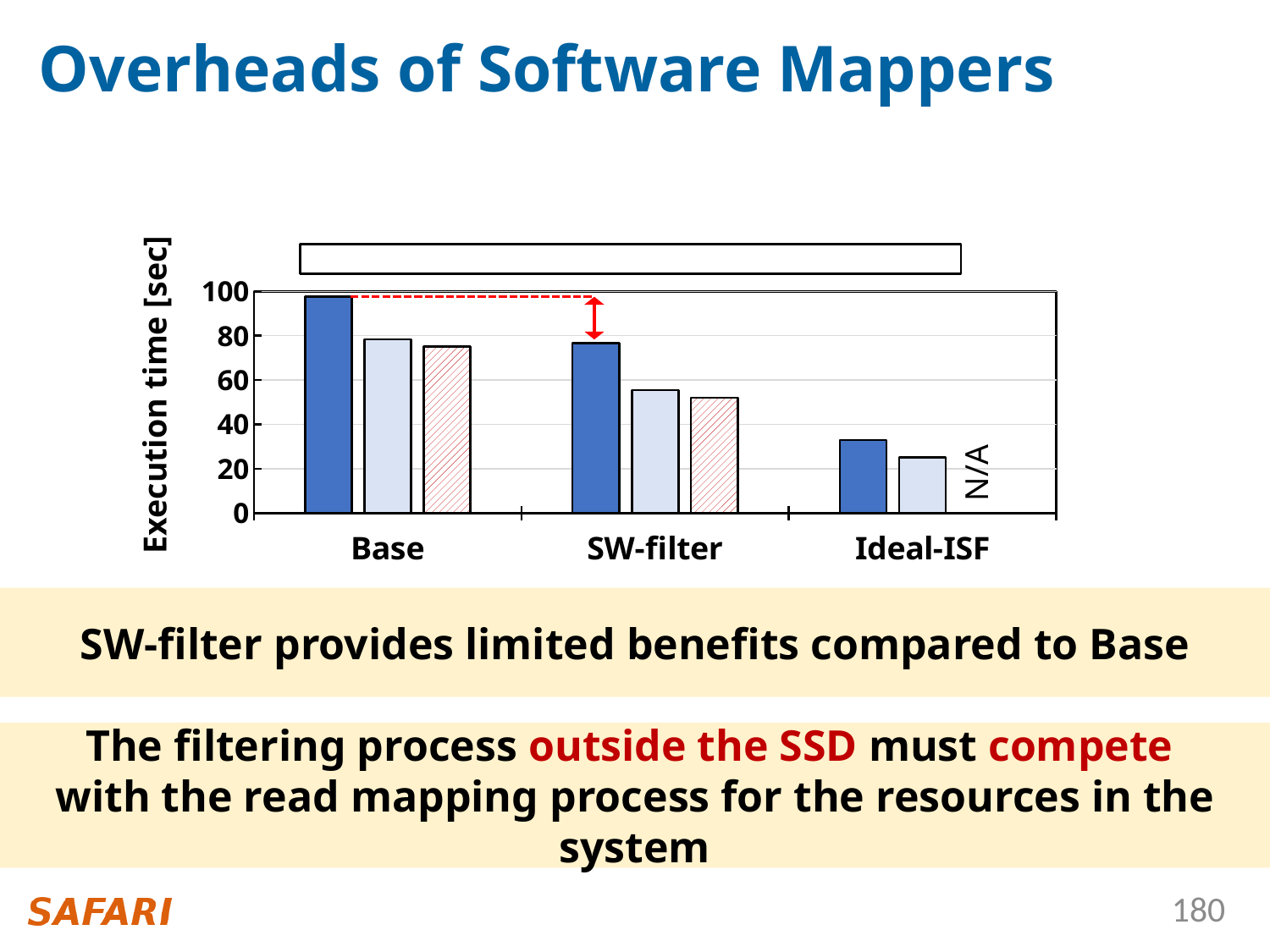
How many categories are shown on the x axis of the chart? 3 Is the value of the dark blue bar for Base greater or less than 80? greater What is shown in place of the red hatched bar for Ideal-ISF? N/A Is the value of the dark blue bar for SW-filter greater or less than 80? less Which category has the tallest bar in the chart? Base What kind of chart is shown on the slide? bar chart Is the value of the red hatched bar for SW-filter greater or less than 60? less What is the label of the y axis of the chart? Execution time [sec] Which is larger: the dark blue bar for Base or the dark blue bar for SW-filter? Base Which category has the shortest bars in the chart? Ideal-ISF Do the dark blue bars rise or fall from Base to Ideal-ISF along the x axis? fall